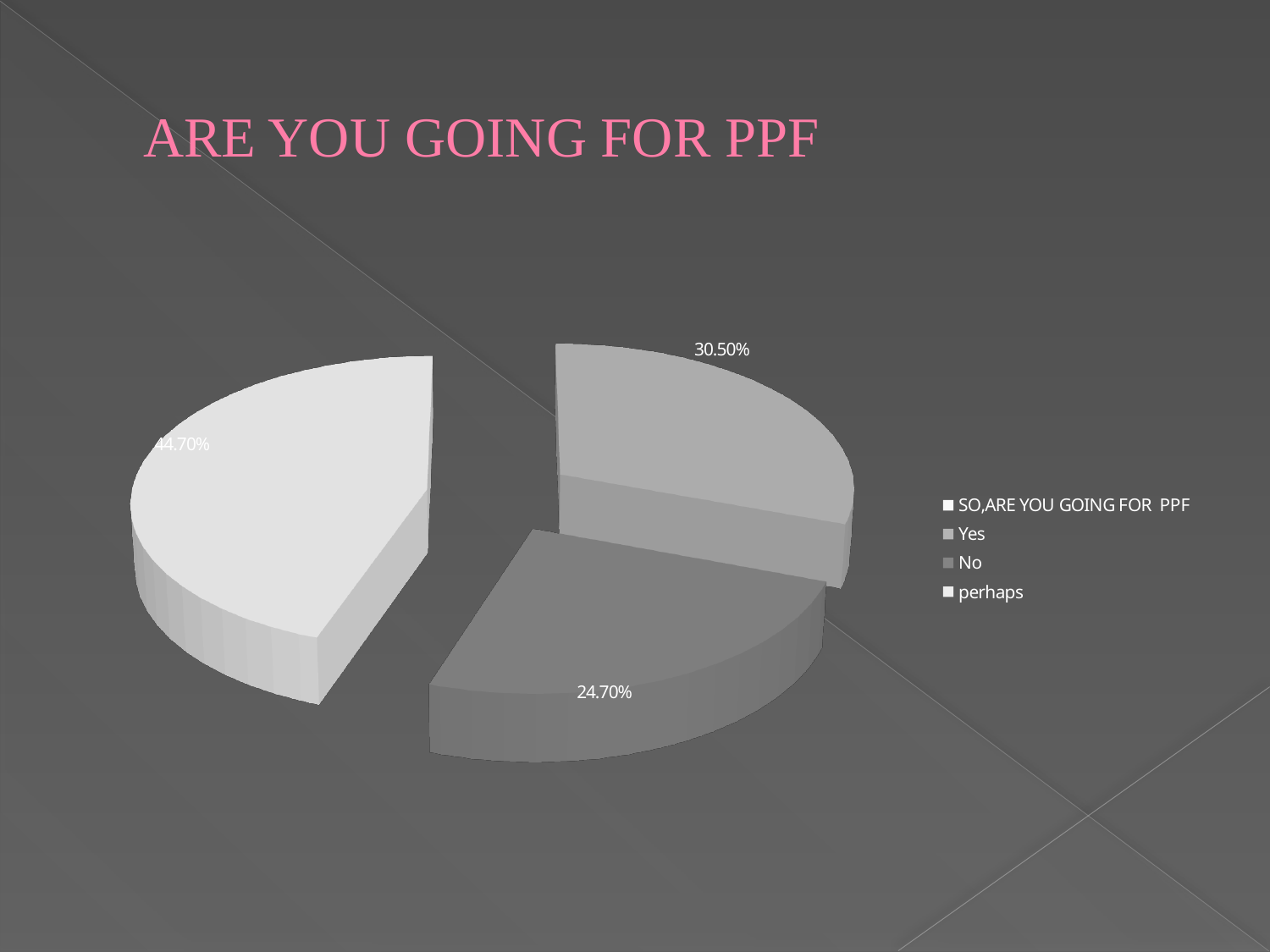
Which is larger, the slice labelled 30.50% or the slice labelled 24.70%? 30.50% What is the value of the slice at the bottom of the pie chart? 24.70% What is the largest percentage shown on the pie chart? 44.70% What is the difference between the 30.50% slice and the 24.70% slice? 5.80% What kind of chart is shown on the slide? pie chart What is the title of the slide's chart? ARE YOU GOING FOR PPF What entries does the legend of the pie chart list? SO,ARE YOU GOING FOR PPF; Yes; No; perhaps What is the difference between the largest slice (44.70%) and the smallest slice (24.70%)? 20.00% Is the largest slice of the pie chart greater or less than 50%? less What is the smallest percentage shown on the pie chart? 24.70% How many slices does the pie chart have? 3 What is the value of the slice at the top right of the pie chart? 30.50%